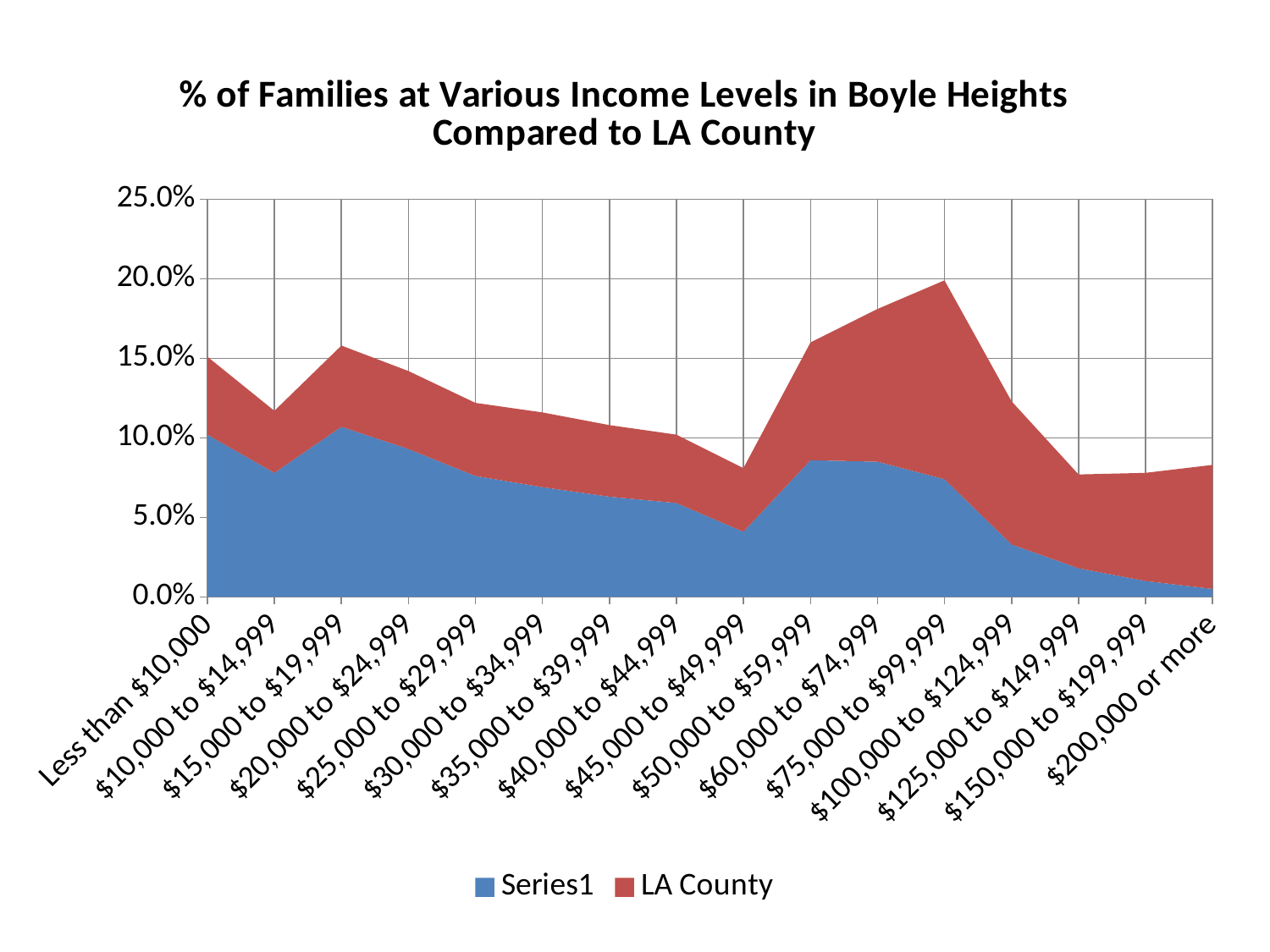
What is the title of the chart? % of Families at Various Income Levels in Boyle Heights Compared to LA County How many series does the legend list? 2 Is the top of the stacked area for $75,000 to $99,999 greater or less than 15.0%? greater For which income level is the Series1 value lowest? $200,000 or more Is the Series1 value for $45,000 to $49,999 greater or less than 5.0%? less Is the Series1 value for Less than $10,000 greater or less than 5.0%? greater What kind of chart is shown on the slide? Area chart Which has the larger Series1 value: $45,000 to $49,999 or $50,000 to $59,999? $50,000 to $59,999 How many income-level categories are shown on the x axis? 16 Which series is shown in red in the legend? LA County For which income level does the stacked area reach its highest point? $75,000 to $99,999